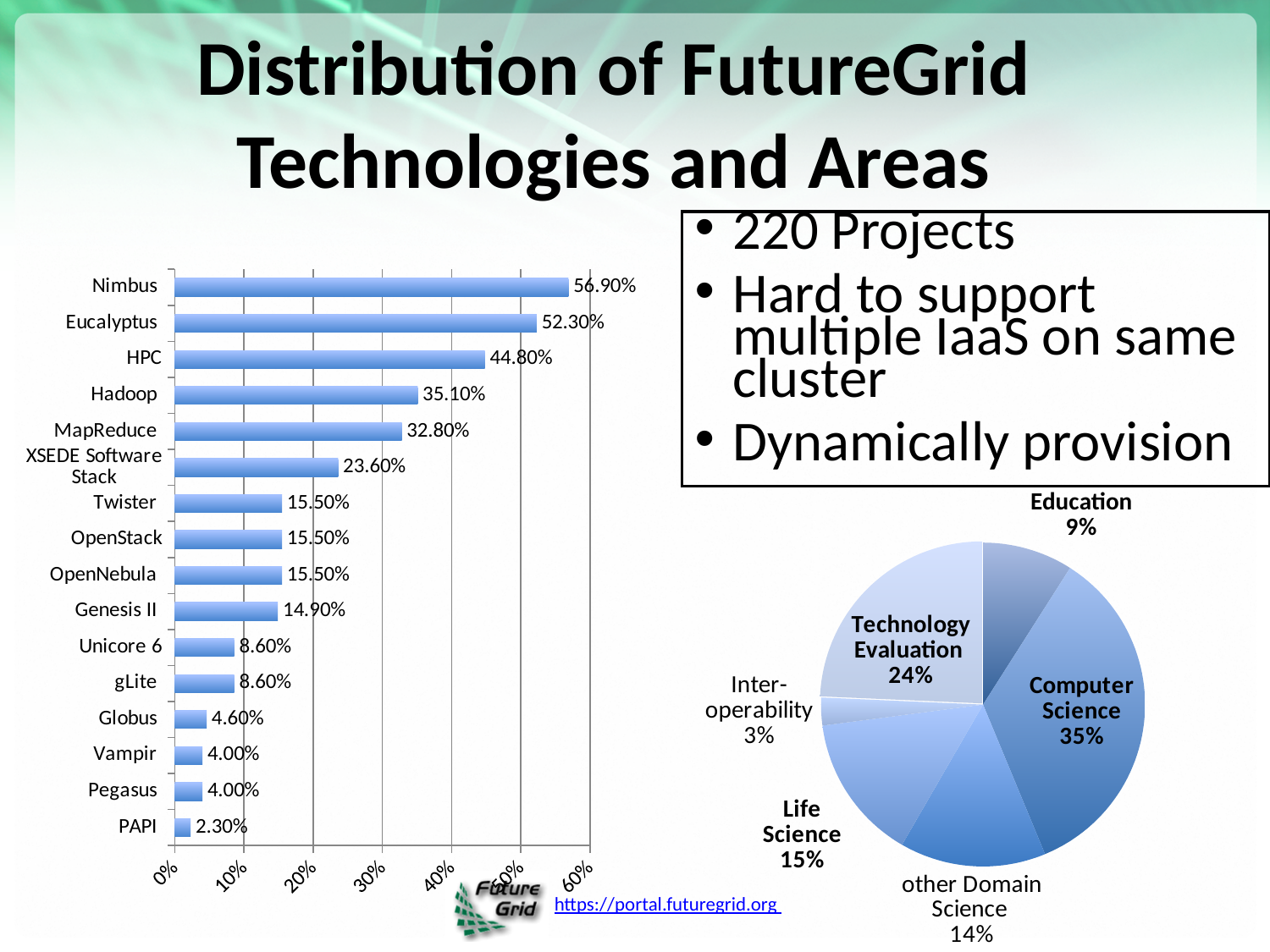
In the bar chart on the left, which is larger, the value for Hadoop or the value for MapReduce? Hadoop In the bar chart on the left, which technology has the highest value? Nimbus In the pie chart on the right, which area has the smallest slice? Interoperability In the pie chart on the right, what share does Computer Science have? 35% In the pie chart on the right, what is the difference between the shares for Technology Evaluation and Life Science? 9% In the pie chart on the right, how many slices are there? 6 In the bar chart on the left, how many technologies are plotted? 16 In the bar chart on the left, what is the value for XSEDE Software Stack? 23.60% In the bar chart on the left, what is the value for Nimbus? 56.90% What kind of chart is the chart on the left of the slide? Bar chart In the bar chart on the left, which technology has the lowest value? PAPI In the bar chart on the left, what is the difference between the values for Eucalyptus and HPC? 7.50%